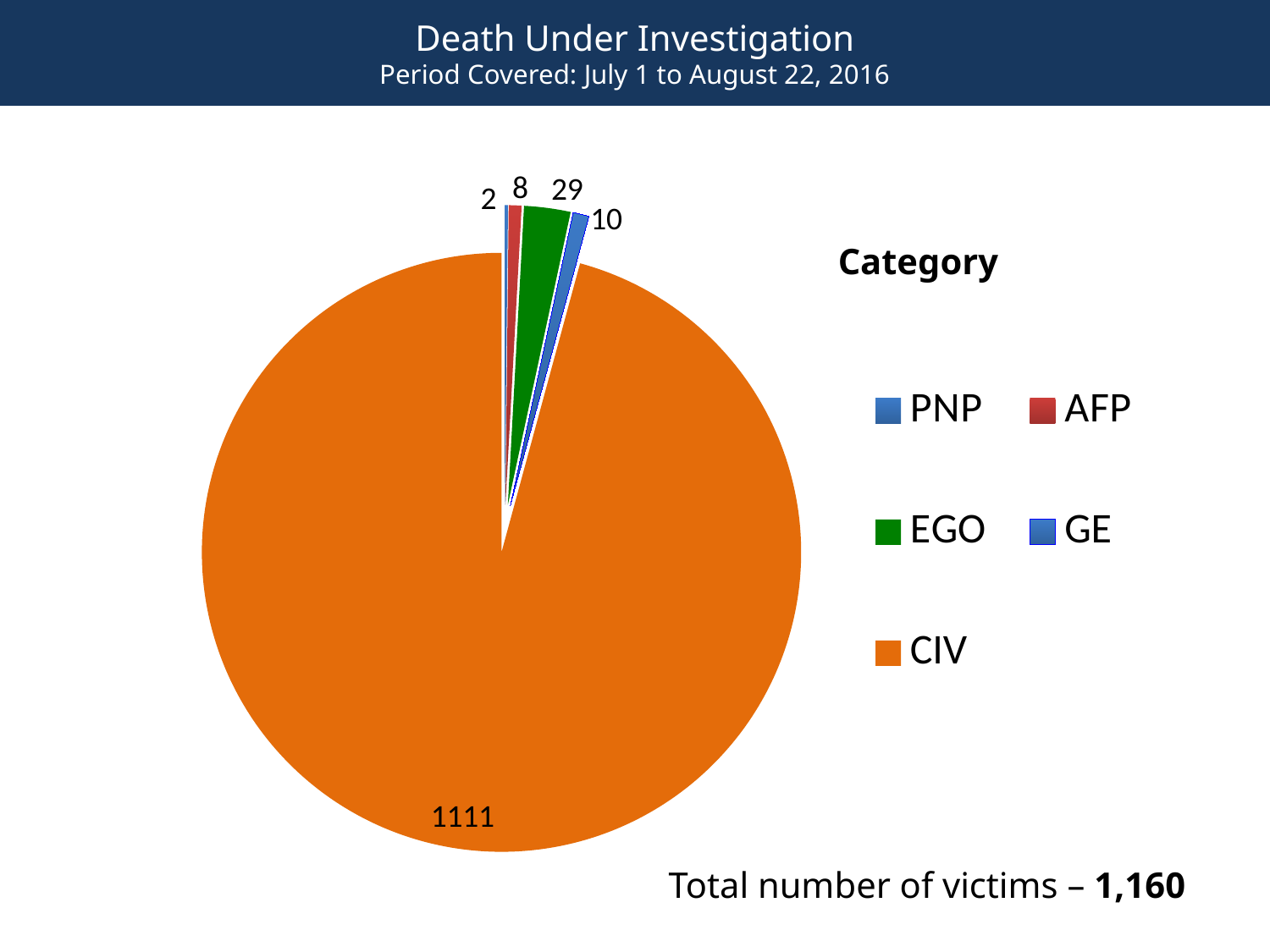
What is the value of the AFP slice? 8 What is the difference between the EGO value and the GE value? 19 What is the value of the PNP slice? 2 What is the value of the EGO slice? 29 What kind of chart is shown on the slide? Pie chart What is the value of the CIV slice in the pie chart? 1111 What is the value of the GE slice? 10 Which category has the largest slice in the pie chart? CIV Which is larger, the AFP value or the GE value? GE How many categories does the pie chart show? 5 What is the total number of victims stated on the slide? 1,160 Which category has the smallest slice in the pie chart? PNP